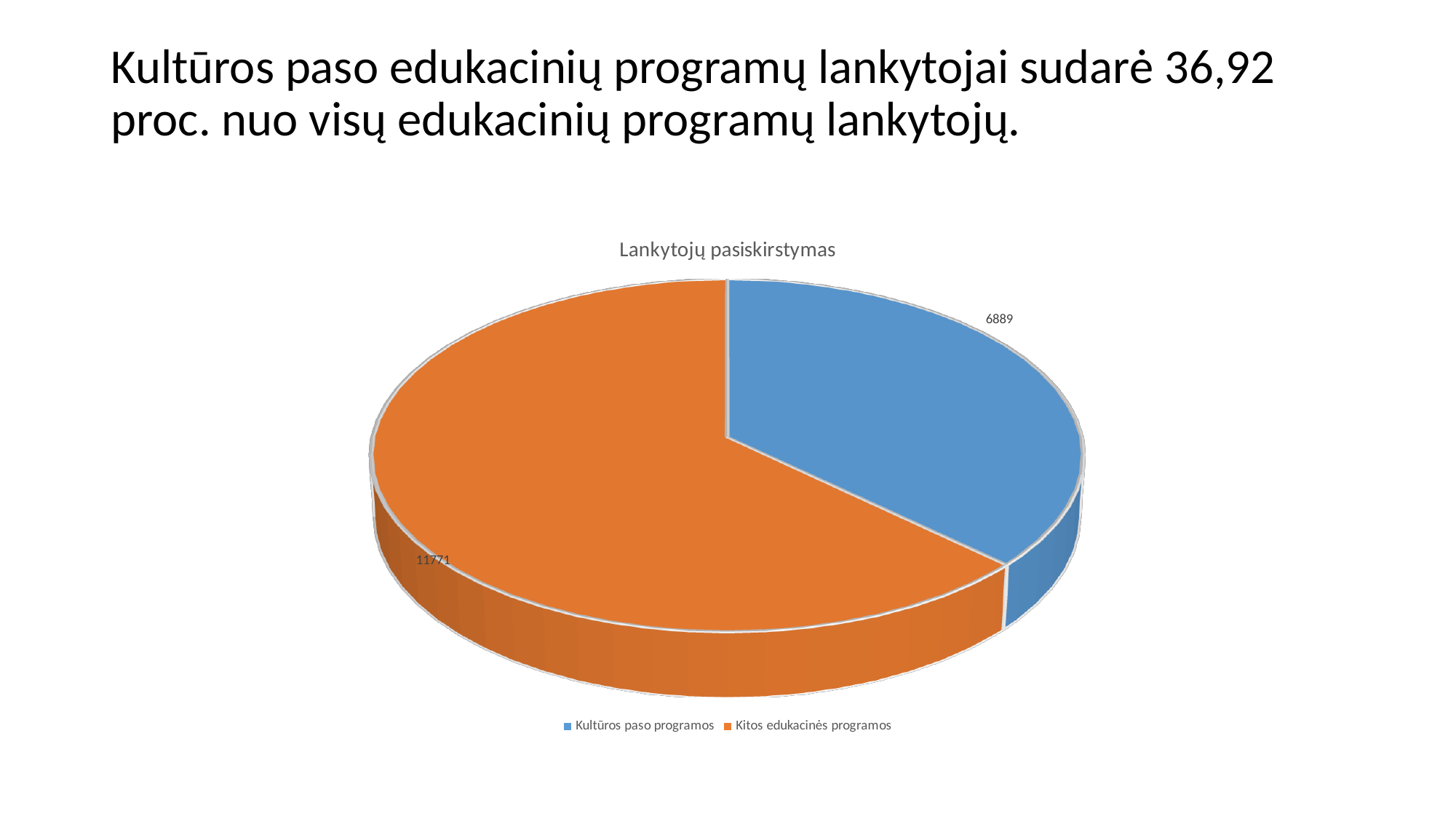
What is the value for Kitos edukacinės programos? 11771 What is the value for Kultūros paso programos? 6889 What type of chart is shown on the slide? pie chart What is the total of the two slices in the pie chart? 18660 Which colour represents Kultūros paso programos in the chart? blue Which is larger, Kultūros paso programos or Kitos edukacinės programos? Kitos edukacinės programos What is the difference between the values for Kitos edukacinės programos and Kultūros paso programos? 4882 How many slices does the pie chart have? 2 What is the title of the chart? Lankytojų pasiskirstymas Which category has the smallest slice? Kultūros paso programos How many entries does the legend list? 2 Which category has the largest slice? Kitos edukacinės programos